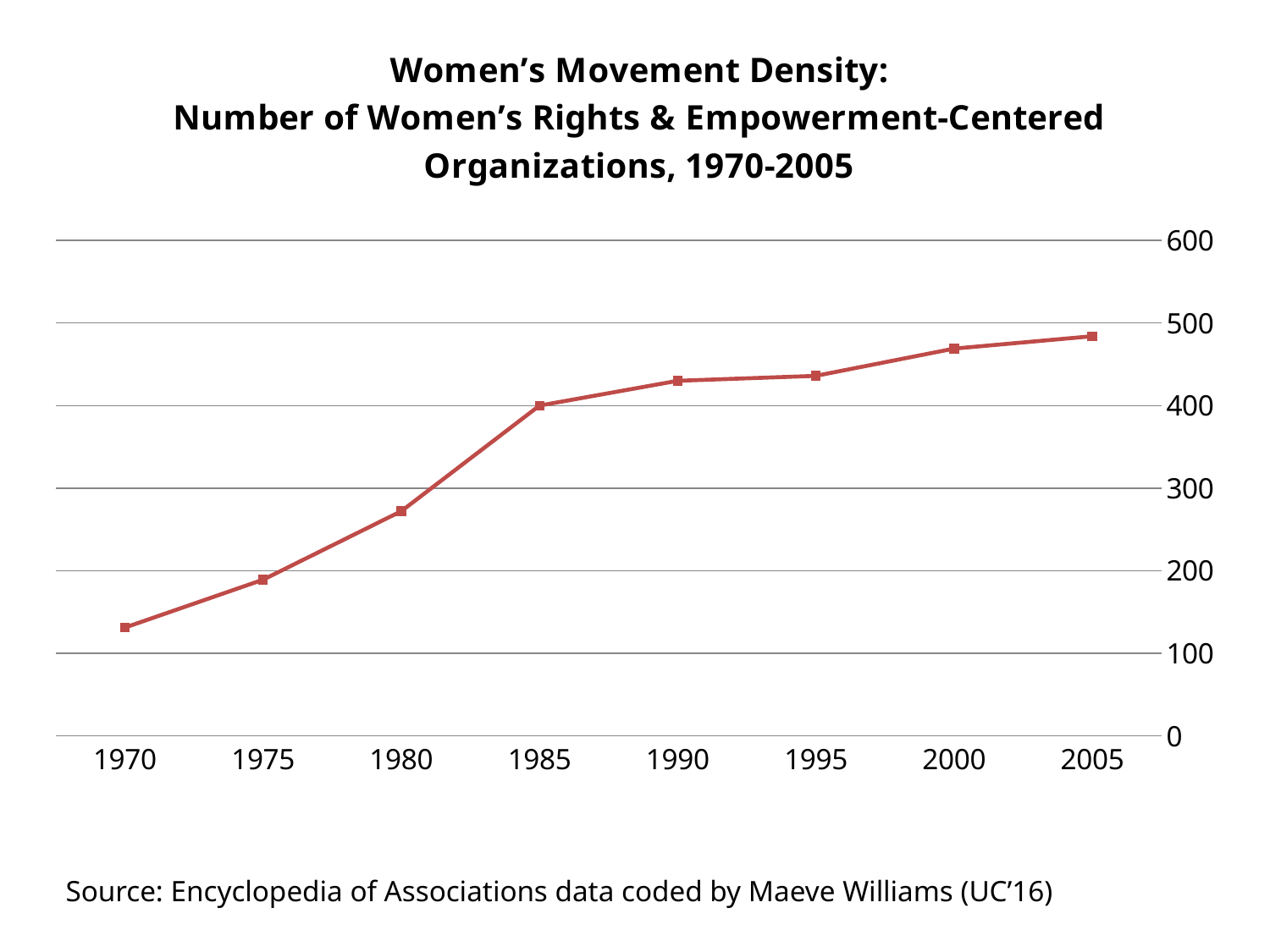
Is the value for 1975 greater or less than 200? less Which year has the highest number of organizations? 2005 Which is larger, the value for 1980 or the value for 1975? 1980 What kind of chart is shown on the slide? line chart How many data points are plotted on the line? 8 Is the value for 2005 greater or less than 500? less Is the value for 1970 greater or less than 100? greater What is the first year shown on the x axis? 1970 Which year has the lowest number of organizations? 1970 Do the values generally rise or fall from 1970 to 2005? rise